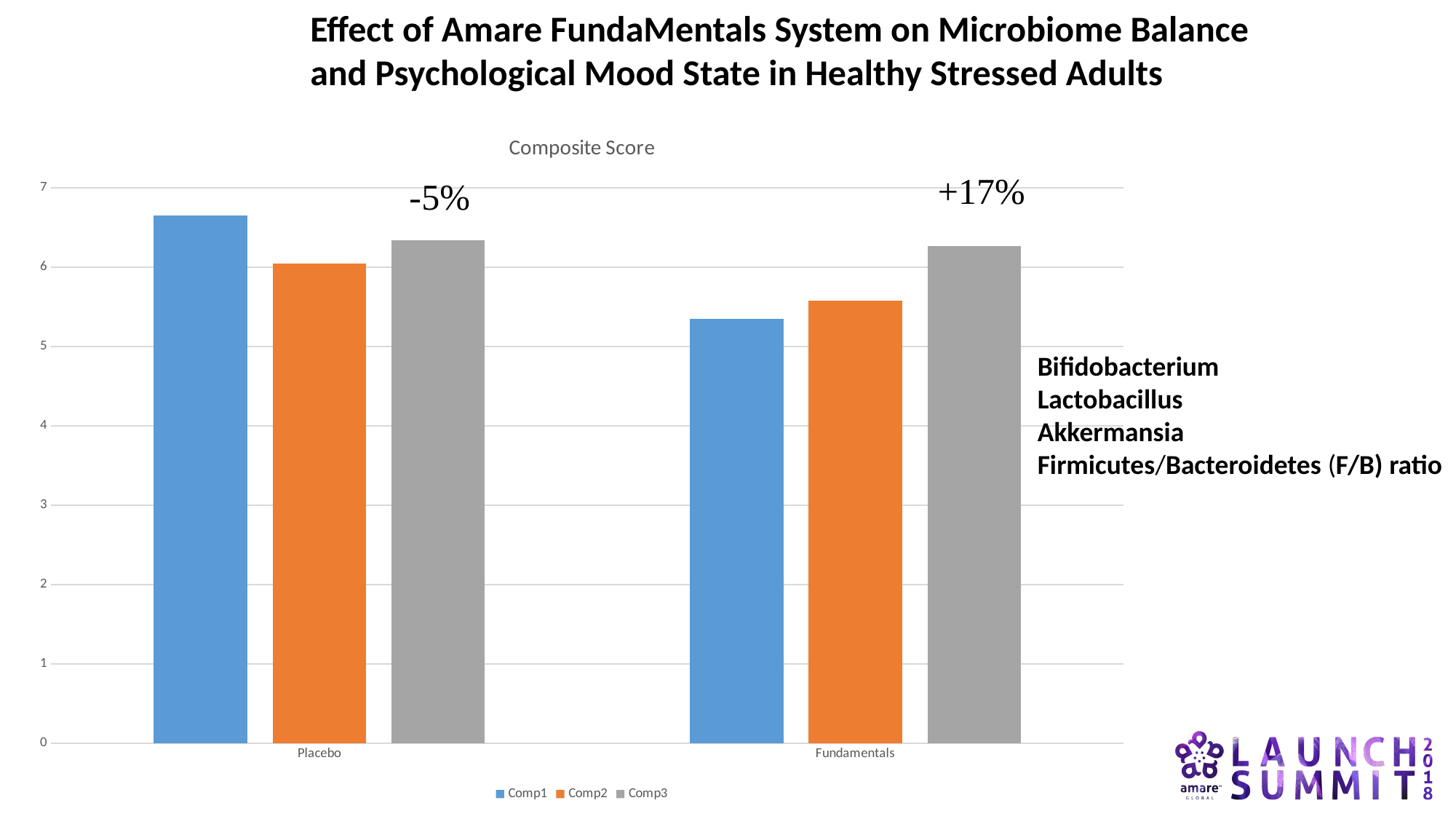
Which series has the lowest value in the Fundamentals category? Comp1 What are the names of the series listed in the legend? Comp1, Comp2, Comp3 Is the Comp1 value for Fundamentals greater or less than 6? less How many series does the chart legend list? 3 Which series has the highest value in the Placebo category? Comp1 Is the Comp3 value for Fundamentals greater or less than 6? greater Which is larger, the Comp1 value for Placebo or the Comp1 value for Fundamentals? Placebo Is the Comp2 value for Fundamentals greater or less than 5? greater What is the title shown above the plot area of the chart? Composite Score What kind of chart is shown on the slide? bar chart How many categories are shown on the x axis of the chart? 2